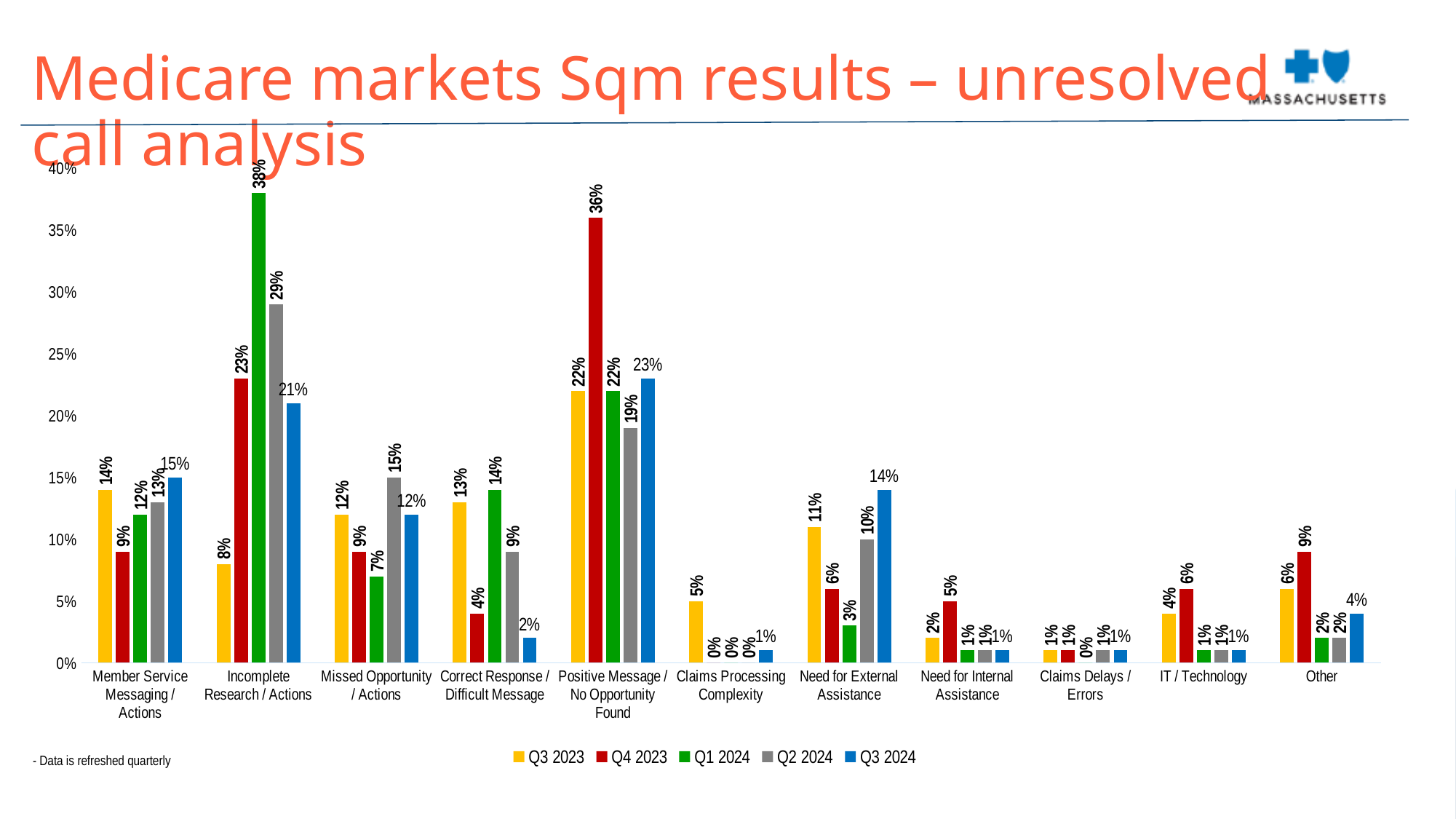
Which is larger for Correct Response / Difficult Message: the Q3 2023 value or the Q1 2024 value? Q1 2024 Which category has the lowest Q3 2023 value? Claims Delays / Errors Which category has the highest Q3 2024 value? Positive Message / No Opportunity Found What is the difference between the Q1 2024 and Q3 2024 values for Incomplete Research / Actions? 17% What is the Q2 2024 value for Missed Opportunity / Actions? 15% How many series does the legend list? 5 How many categories are shown on the x axis? 11 What is the Q4 2023 value for Positive Message / No Opportunity Found? 36% What is the Q3 2024 value for Need for External Assistance? 14% What is the Q1 2024 value for Incomplete Research / Actions? 38% Which series is shown in blue in the legend? Q3 2024 What kind of chart is shown on the slide? Bar chart